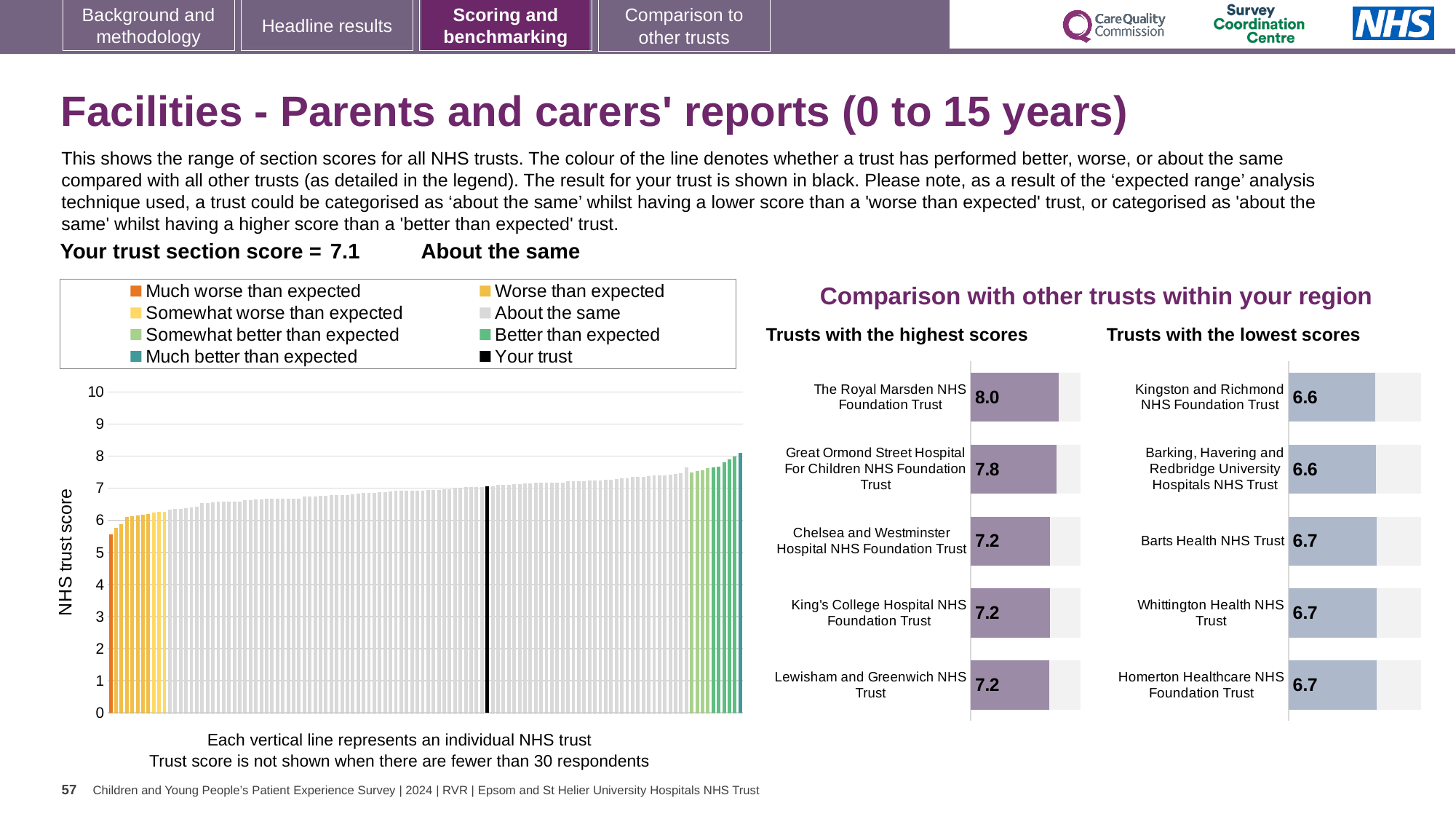
In the large 'NHS trust score' chart on the left, is the value for the black 'Your trust' bar greater or less than 5? greater How many entries does the legend of the large 'NHS trust score' chart on the left list? 8 In the large 'NHS trust score' chart on the left, do the bar values rise or fall from left to right? rise In the 'Trusts with the lowest scores' chart, what is the score for Kingston and Richmond NHS Foundation Trust? 6.6 In the 'Trusts with the highest scores' chart, which has the larger score: The Royal Marsden NHS Foundation Trust or Chelsea and Westminster Hospital NHS Foundation Trust? The Royal Marsden NHS Foundation Trust In the 'Trusts with the highest scores' chart, which trust has the highest score? The Royal Marsden NHS Foundation Trust In the 'Trusts with the highest scores' chart, what is the score for Great Ormond Street Hospital For Children NHS Foundation Trust? 7.8 In the 'Trusts with the highest scores' chart, what is the difference between the scores of The Royal Marsden NHS Foundation Trust and Great Ormond Street Hospital For Children NHS Foundation Trust? 0.2 In the 'Trusts with the lowest scores' chart, what is the score for Barts Health NHS Trust? 6.7 In the 'Trusts with the highest scores' chart, what is the score for The Royal Marsden NHS Foundation Trust? 8.0 In the 'Trusts with the highest scores' chart, what is the difference between the scores of The Royal Marsden NHS Foundation Trust and Lewisham and Greenwich NHS Trust? 0.8 How many trusts are listed in the 'Trusts with the lowest scores' chart? 5